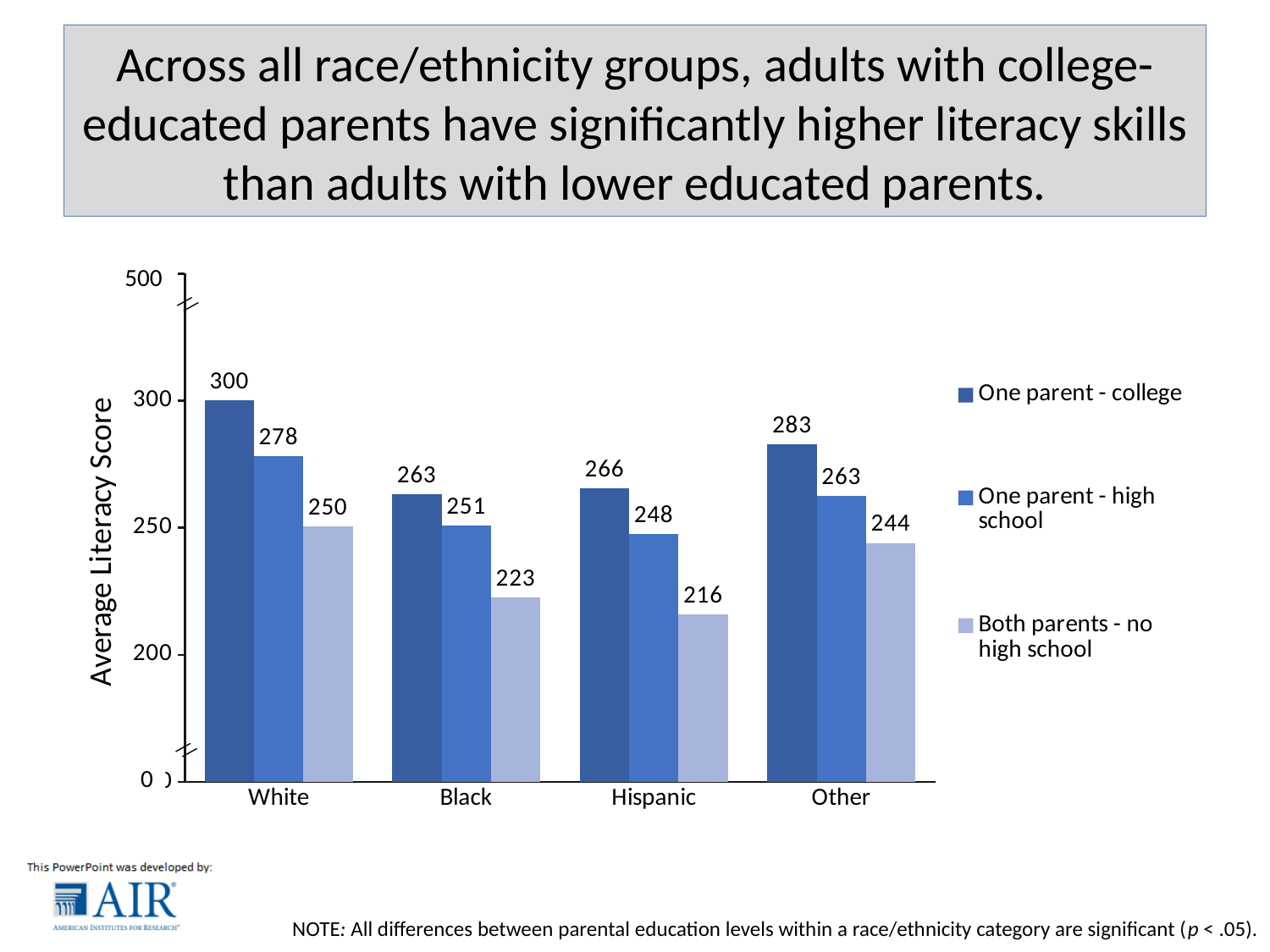
How many race/ethnicity categories are shown on the x axis? 4 What is the difference between the 'One parent - college' and 'Both parents - no high school' scores for White adults? 50 Which race/ethnicity group has the lowest average literacy score for the 'Both parents - no high school' series? Hispanic What kind of chart is shown on the slide? Bar chart Which race/ethnicity group has the highest average literacy score for the 'One parent - college' series? White Which is larger: the 'One parent - college' score for Black adults or for Hispanic adults? Hispanic What is the difference between the 'One parent - college' and 'One parent - high school' scores for Other adults? 20 What is the average literacy score for White adults with one parent who attended college? 300 What is the average literacy score for Hispanic adults whose parents both have no high school education? 216 What is the average literacy score for Black adults with one parent who attended high school? 251 How many series does the legend list? 3 What is the label of the y axis? Average Literacy Score